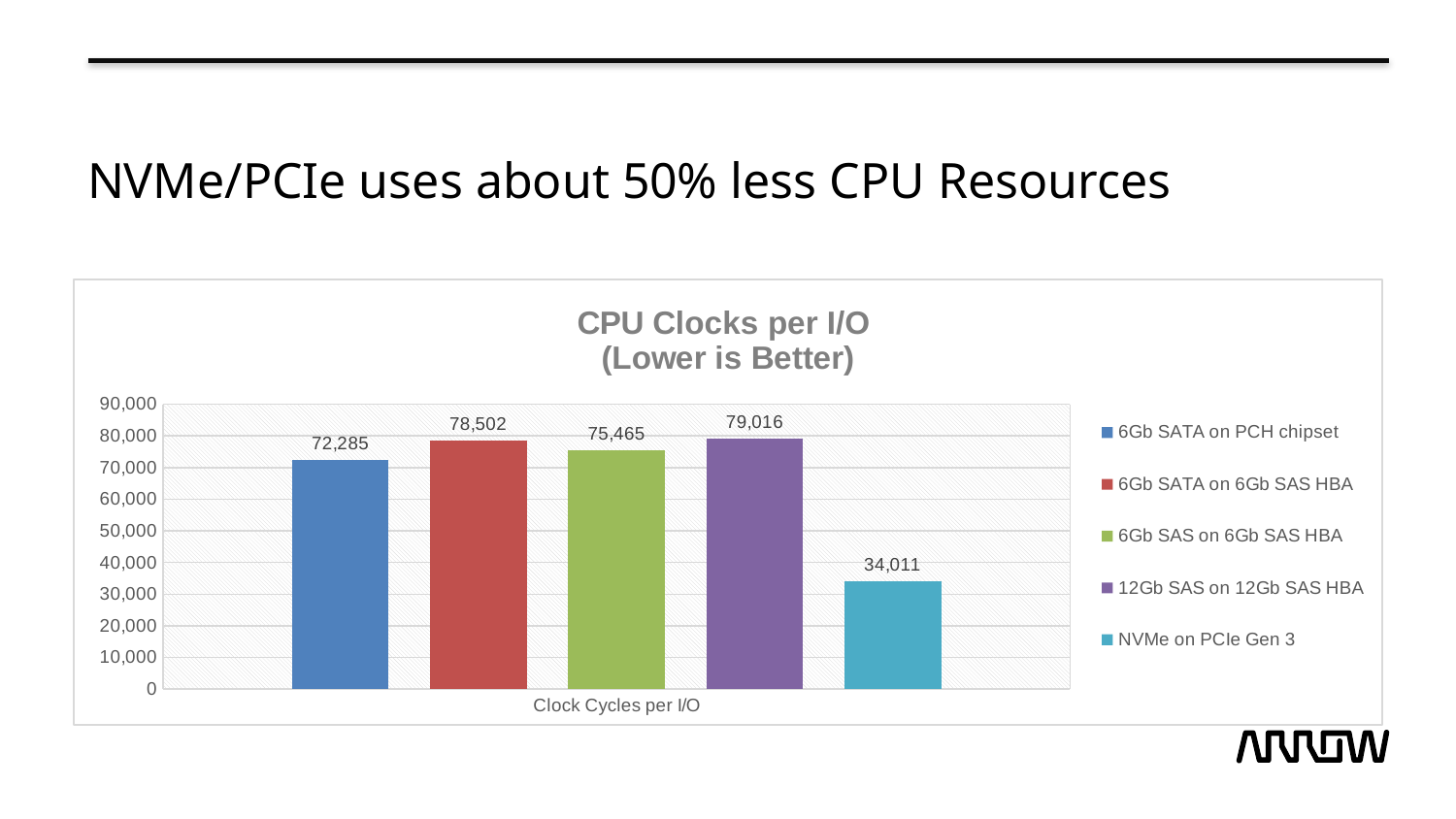
What is the value for 6Gb SAS on 6Gb SAS HBA? 75,465 Is the value for NVMe on PCIe Gen 3 greater or less than 40,000? less What is the value for NVMe on PCIe Gen 3? 34,011 What is the difference between the values for 6Gb SATA on 6Gb SAS HBA and 6Gb SATA on PCH chipset? 6,217 Which series has the highest value? 12Gb SAS on 12Gb SAS HBA What kind of chart is shown on the slide? bar chart Which series has the lowest value? NVMe on PCIe Gen 3 What is the value for 6Gb SATA on PCH chipset? 72,285 How many series does the legend list? 5 Which is larger, the value for 6Gb SATA on 6Gb SAS HBA or the value for 6Gb SAS on 6Gb SAS HBA? 6Gb SATA on 6Gb SAS HBA What is the difference between the values for 12Gb SAS on 12Gb SAS HBA and NVMe on PCIe Gen 3? 45,005 What is the value for 12Gb SAS on 12Gb SAS HBA? 79,016